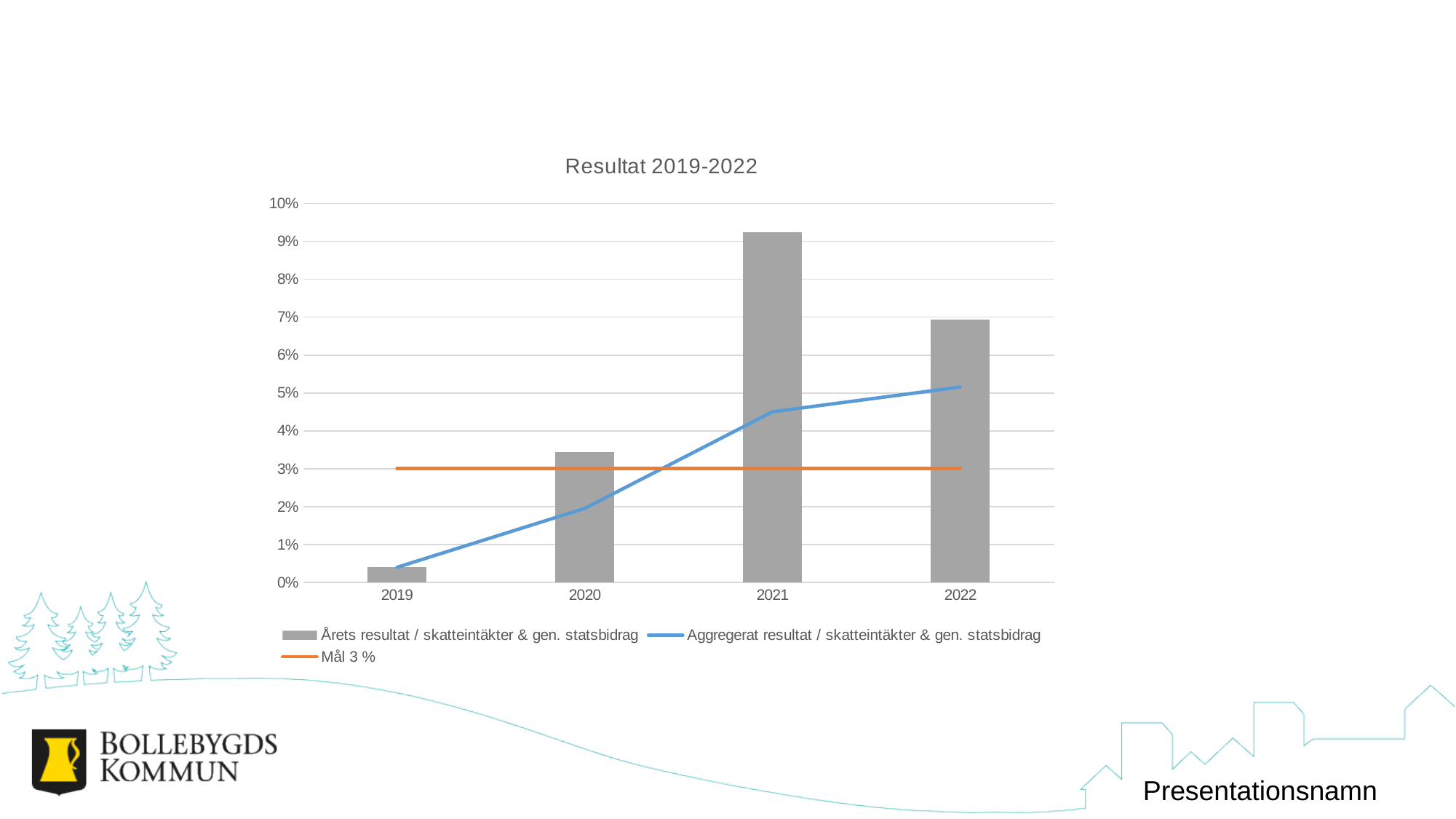
How many series does the legend list? 3 What is the title of the chart? Resultat 2019-2022 What is the label of the orange line in the legend? Mål 3 % How many years are shown on the x axis of the chart? 4 Does the Aggregerat resultat / skatteintäkter & gen. statsbidrag line rise or fall from 2019 to 2022? rise Which year has the lowest bar for Årets resultat / skatteintäkter & gen. statsbidrag? 2019 Is the bar for 2019 greater or less than 1%? less What kind of chart is shown on the slide? bar chart with line series Which bar is taller, 2021 or 2022? 2021 Is the bar for 2021 greater or less than 8%? greater Is the bar for 2022 greater or less than 6%? greater Which year has the highest bar for Årets resultat / skatteintäkter & gen. statsbidrag? 2021